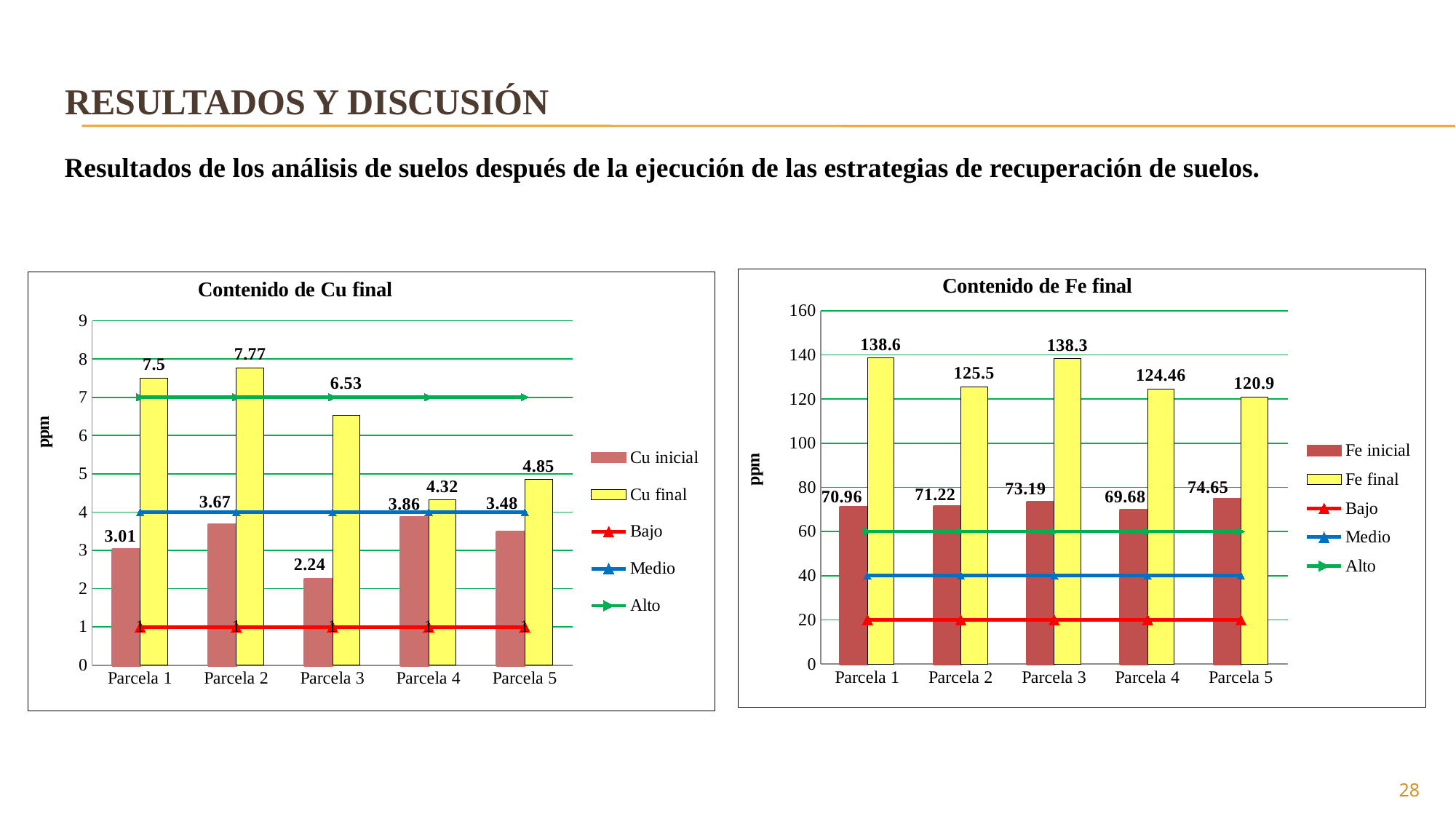
In the 'Contenido de Cu final' chart, which parcela has the highest Cu final value? Parcela 2 In the 'Contenido de Cu final' chart, what is the difference between Cu final and Cu inicial for Parcela 1? 4.49 How many parcelas are shown on the x axis of the 'Contenido de Cu final' chart? 5 In the 'Contenido de Fe final' chart, which is larger: Fe inicial for Parcela 3 or Fe inicial for Parcela 4? Parcela 3 In the 'Contenido de Cu final' chart, which parcela has the lowest Cu inicial value? Parcela 3 How many series does the legend of the 'Contenido de Fe final' chart list? 5 In the 'Contenido de Fe final' chart, what is the Fe inicial value for Parcela 5? 74.65 What kind of chart is 'Contenido de Cu final'? combination bar and line chart In the 'Contenido de Cu final' chart, what is the Cu final value for Parcela 3? 6.53 In the 'Contenido de Fe final' chart, is the Fe final value for Parcela 2 greater or less than 120? greater In the 'Contenido de Fe final' chart, at what ppm level does the 'Alto' line sit? 60 In the 'Contenido de Fe final' chart, which parcela has the lowest Fe final value? Parcela 5